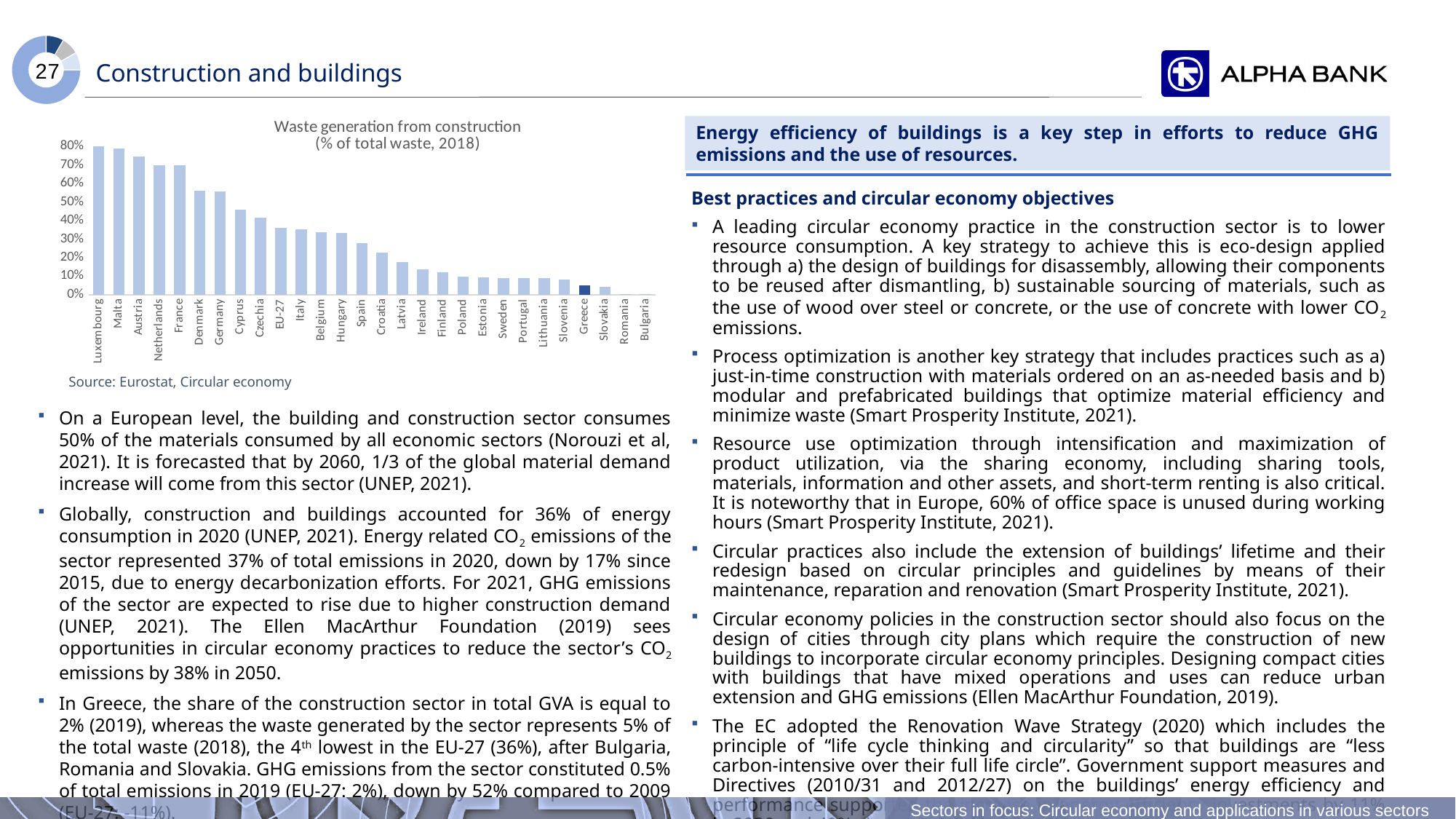
Is the value for Germany greater or less than 50%? greater Which country's bar is highlighted in a darker blue colour than the others? Greece Is the value for Luxembourg greater or less than 70%? greater Do the values rise or fall moving from left to right along the x axis? fall Is the value for Netherlands greater or less than 60%? greater What is the title of the chart? Waste generation from construction (% of total waste, 2018) Which category has the lowest value in the chart? Bulgaria How many countries/categories are shown on the x axis of the chart? 28 What kind of chart is shown on the slide? Bar chart Which has a higher value, Austria or Italy? Austria